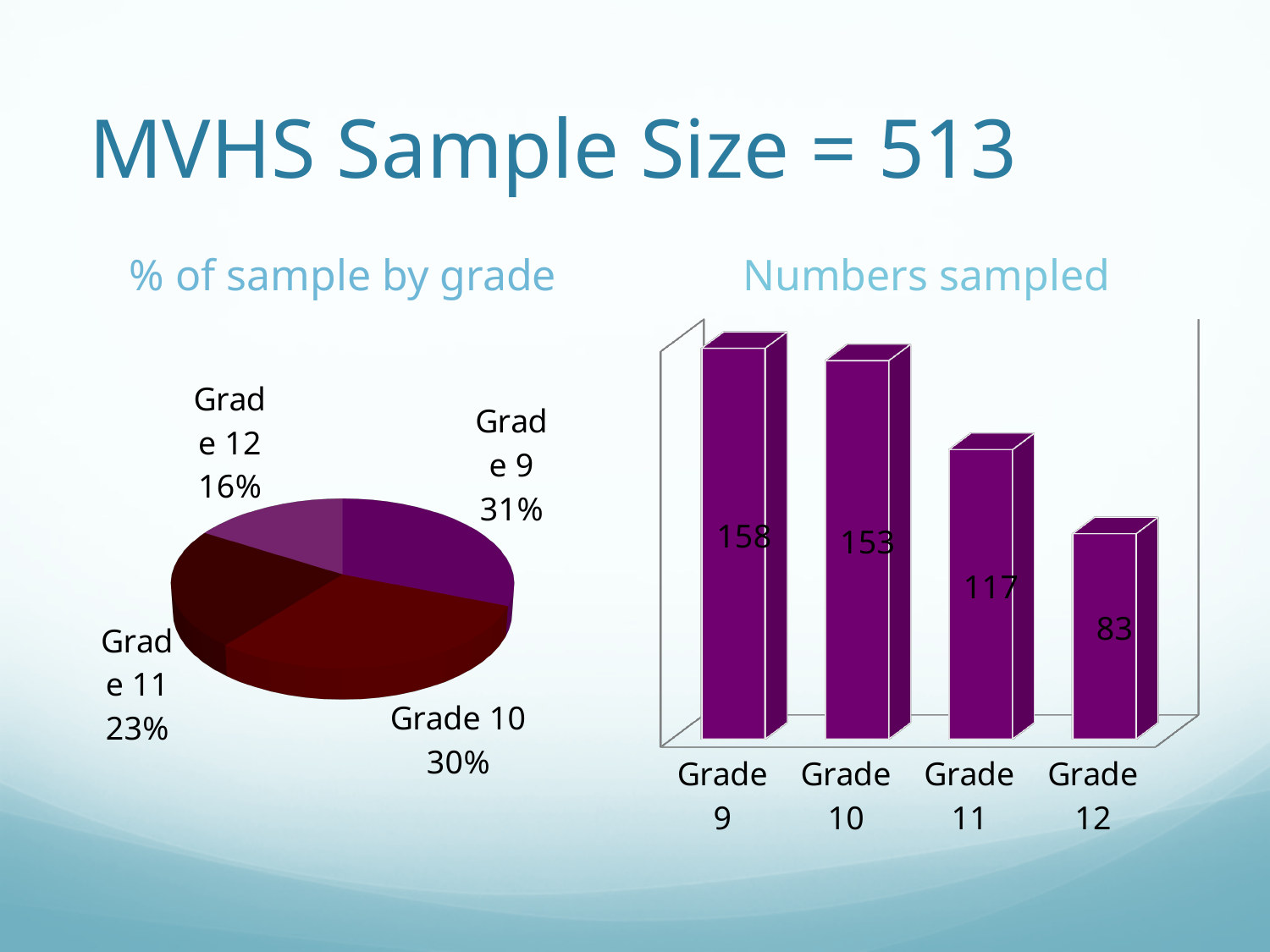
In the 'Numbers sampled' chart, what is the value for Grade 9? 158 What kind of chart is the '% of sample by grade' chart? Pie chart In the 'Numbers sampled' chart, what is the value for Grade 12? 83 In the 'Numbers sampled' chart, how many grades are shown? 4 What kind of chart is the 'Numbers sampled' chart? Bar chart In the 'Numbers sampled' chart, do the values rise or fall from Grade 9 to Grade 12? Fall In the '% of sample by grade' chart, which grade has the largest slice? Grade 9 In the '% of sample by grade' chart, what is the difference between the Grade 10 and Grade 12 shares? 14% In the '% of sample by grade' chart, what share does Grade 11 have? 23% In the 'Numbers sampled' chart, which is larger, Grade 11 or Grade 12? Grade 11 In the 'Numbers sampled' chart, which grade has the lowest value? Grade 12 In the 'Numbers sampled' chart, what is the difference between Grade 10 and Grade 11? 36